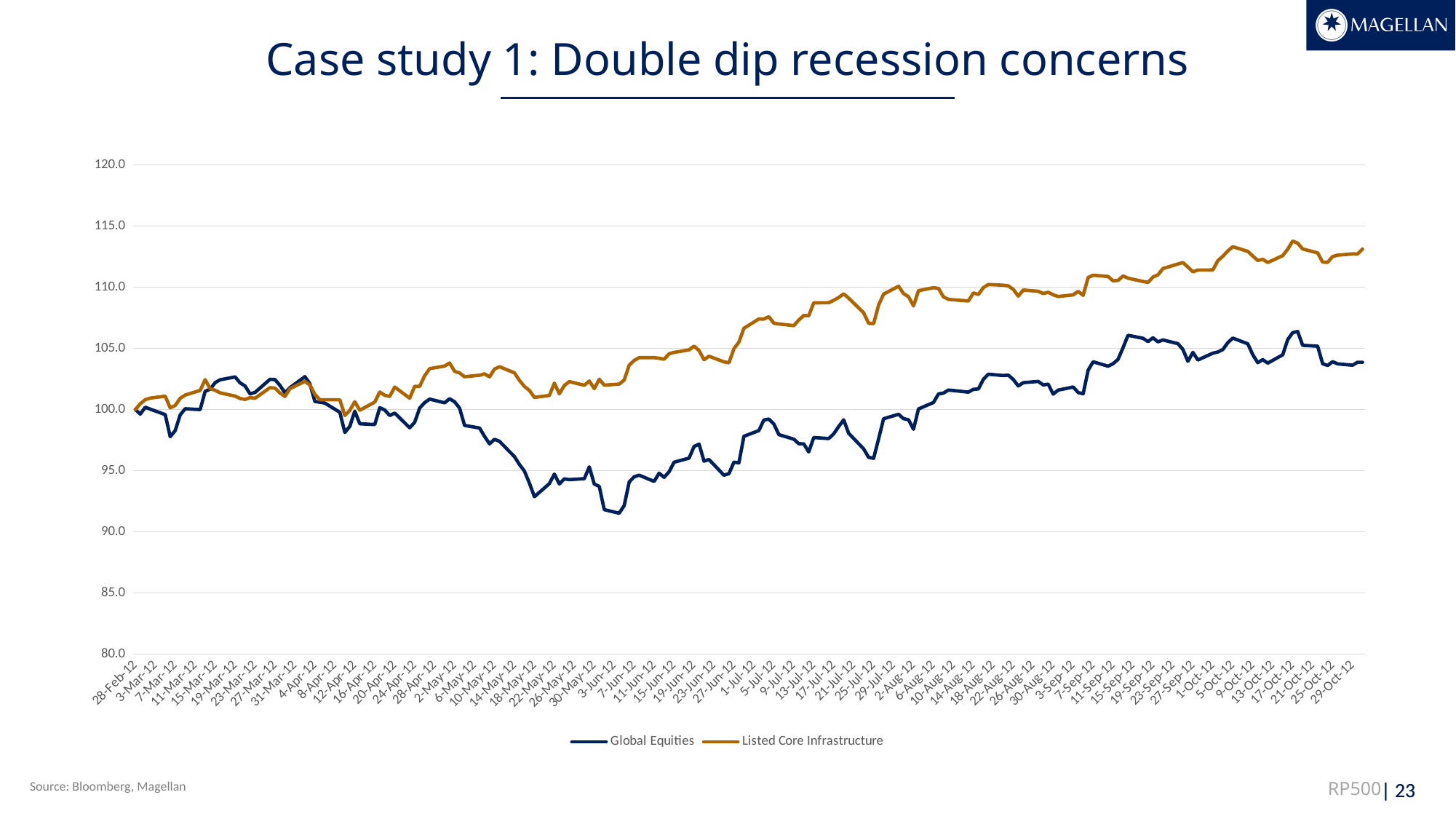
Does the Listed Core Infrastructure line generally rise or fall from 28-Feb-12 to 29-Oct-12? Rise Is the value for Global Equities at 29-Oct-12 greater or less than 100.0? greater How many series does the legend list? 2 What kind of chart is shown on the slide? Line chart Is the value for Listed Core Infrastructure at 29-Oct-12 greater or less than 110.0? greater Which series reaches the lowest value anywhere on the chart? Global Equities What is the title of the slide containing the chart? Case study 1: Double dip recession concerns At 29-Oct-12, which series has the higher value, Global Equities or Listed Core Infrastructure? Listed Core Infrastructure Which series reaches the highest value anywhere on the chart? Listed Core Infrastructure Is the value for Listed Core Infrastructure at 3-Jun-12 greater or less than 100.0? greater What are the two series named in the legend? Global Equities and Listed Core Infrastructure